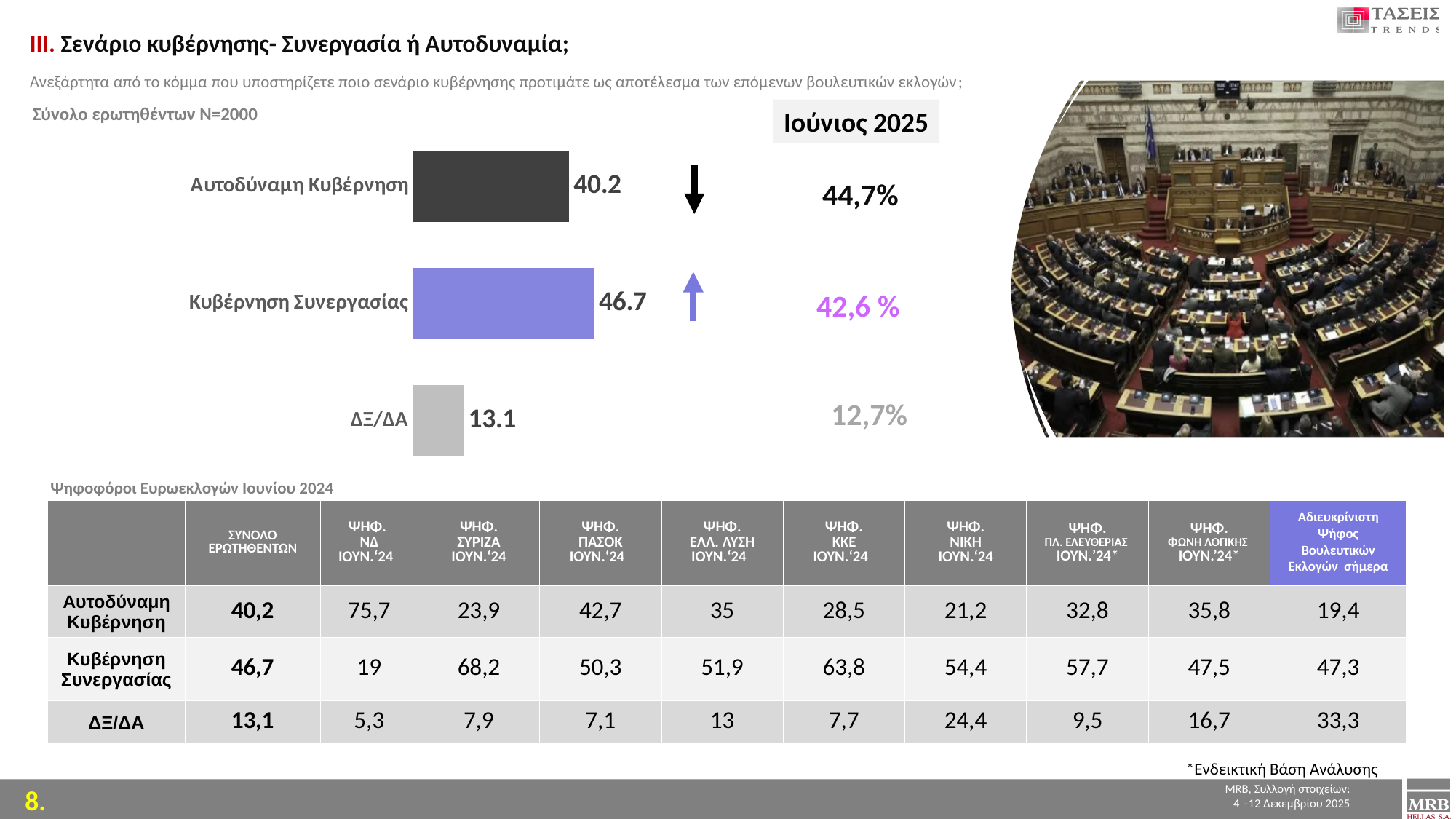
What value does the bar chart show for Κυβέρνηση Συνεργασίας? 46.7 What is the difference between the values for Κυβέρνηση Συνεργασίας and Αυτοδύναμη Κυβέρνηση in the bar chart? 6.5 What is the Ιούνιος 2025 value shown next to the bar chart for Αυτοδύναμη Κυβέρνηση? 44,7% What is the Ιούνιος 2025 value shown next to the bar chart for Κυβέρνηση Συνεργασίας? 42,6 % Which is larger in the bar chart: Αυτοδύναμη Κυβέρνηση or ΔΞ/ΔΑ? Αυτοδύναμη Κυβέρνηση What value does the bar chart show for Αυτοδύναμη Κυβέρνηση? 40.2 What kind of chart is shown on the slide? Bar chart How many categories are shown in the bar chart? 3 Which category has the highest value in the bar chart? Κυβέρνηση Συνεργασίας What colour is the bar for Κυβέρνηση Συνεργασίας in the bar chart? Blue/purple What value does the bar chart show for ΔΞ/ΔΑ? 13.1 Which category has the lowest value in the bar chart? ΔΞ/ΔΑ